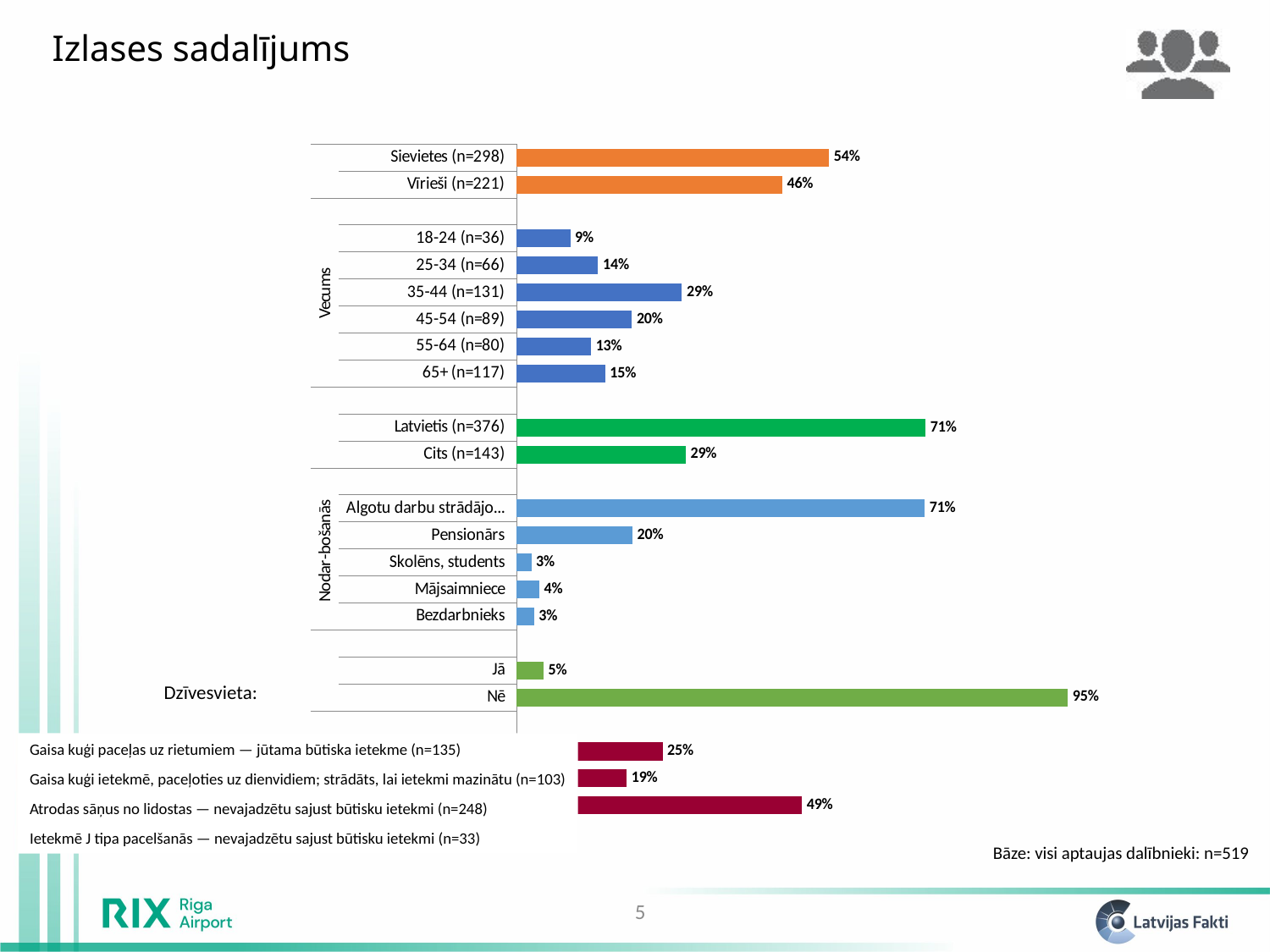
In the main chart, what is the difference between Latvietis (n=376) and Cits (n=143)? 42 percentage points What kind of chart is the main chart on the slide? Bar chart In the main chart, which is larger: the value for Jā or the value for Nē? Nē In the main chart, what is the value for 35-44 (n=131)? 29% In the bottom chart, what is the difference between the values for 'Gaisa kuģi paceļas uz rietumiem' (n=135) and 'Gaisa kuģi ietekmē, paceļoties uz dienvidiem' (n=103)? 6 percentage points In the main chart, which age group in the Vecums section has the lowest value? 18-24 (n=36) In the main chart, what is the value for Sievietes (n=298)? 54% In the bottom chart, what is the value for 'Atrodas sāņus no lidostas — nevajadzētu sajust būtisku ietekmi (n=248)'? 49% In the main chart, how many categories are listed in the Nodar-bošanās section? 5 In the main chart, which age group in the Vecums section has the highest value? 35-44 (n=131) In the main chart, what is the value for Pensionārs? 20%